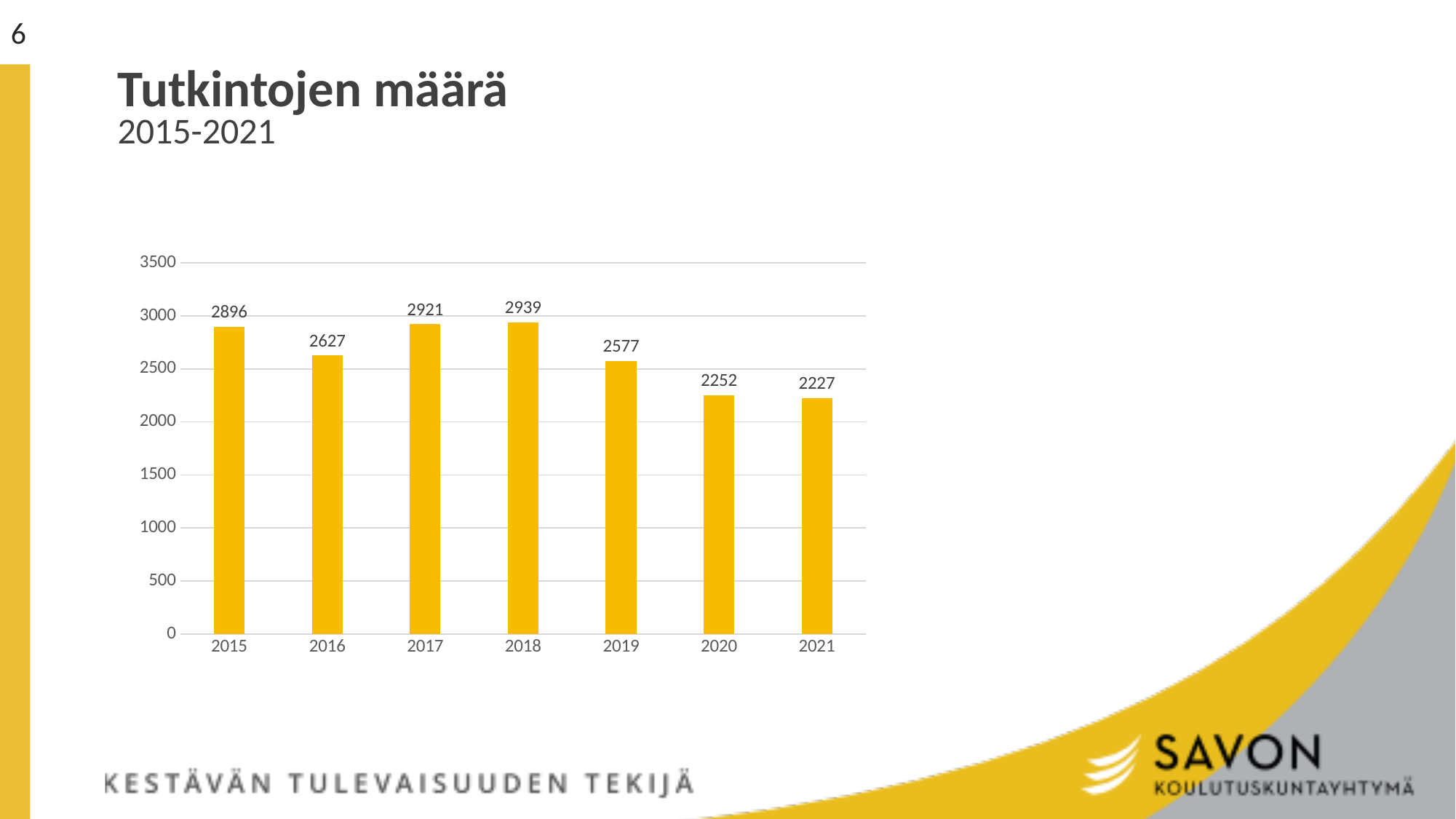
What is the difference between the values for 2018 and 2021? 712 What is the value for 2021? 2227 Is the value for 2020 greater or less than 2500? less Which year has the highest value? 2018 What is the value for 2015? 2896 What is the value for 2019? 2577 What kind of chart is shown on the slide? bar chart Do the values rise or fall from 2018 to 2021? fall Which is larger, the value for 2016 or the value for 2019? 2016 Which year has the lowest value? 2021 How many years are shown on the x axis? 7 What is the difference between the values for 2015 and 2016? 269